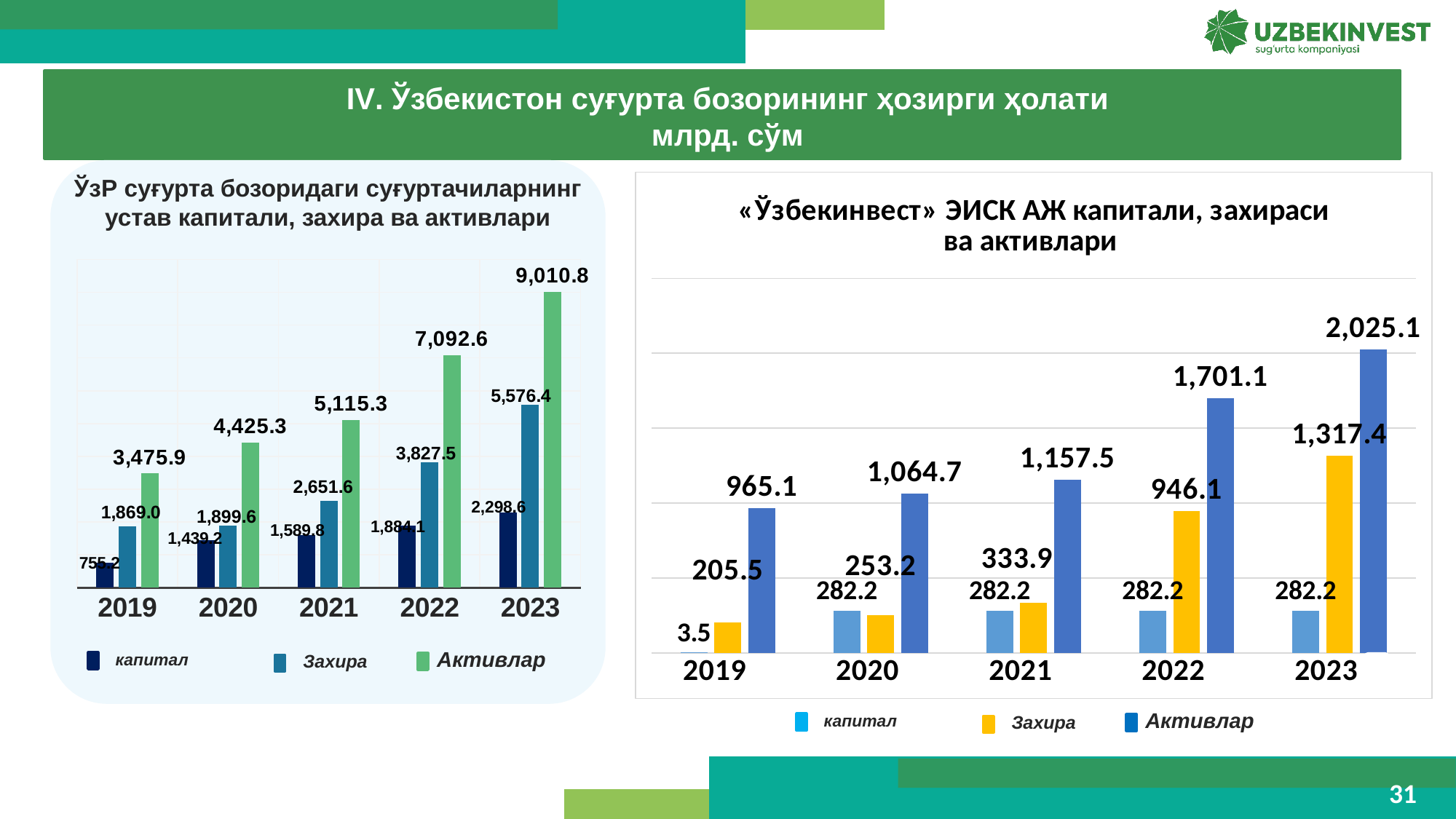
In the left chart (ЎзР суғурта бозоридаги суғурталарнинг устав капитали, захира ва активлари), what is the value of Активлар for 2023? 9,010.8 In the left chart, which year has the highest Активлар value? 2023 In the left chart, what is the value of Захира for 2022? 3,827.5 In the right chart, which year has the lowest Захира value? 2019 In the left chart, what is the value of капитал for 2019? 755.2 In the right chart, what is the value of Захира for 2022? 946.1 In the right chart («Ўзбекинвест» ЭИСК АЖ капитали, захираси ва активлари), what is the value of Активлар for 2023? 2,025.1 In the left chart, what is the difference between Активлар in 2023 and Активлар in 2022? 1,918.2 In the right chart, what is the value of капитал for 2019? 3.5 In the right chart, which is larger: Захира in 2023 or Активлар in 2020? Захира in 2023 In the left chart, does the Захира series rise or fall from 2019 to 2023? rise How many series does the legend of the right chart list? 3